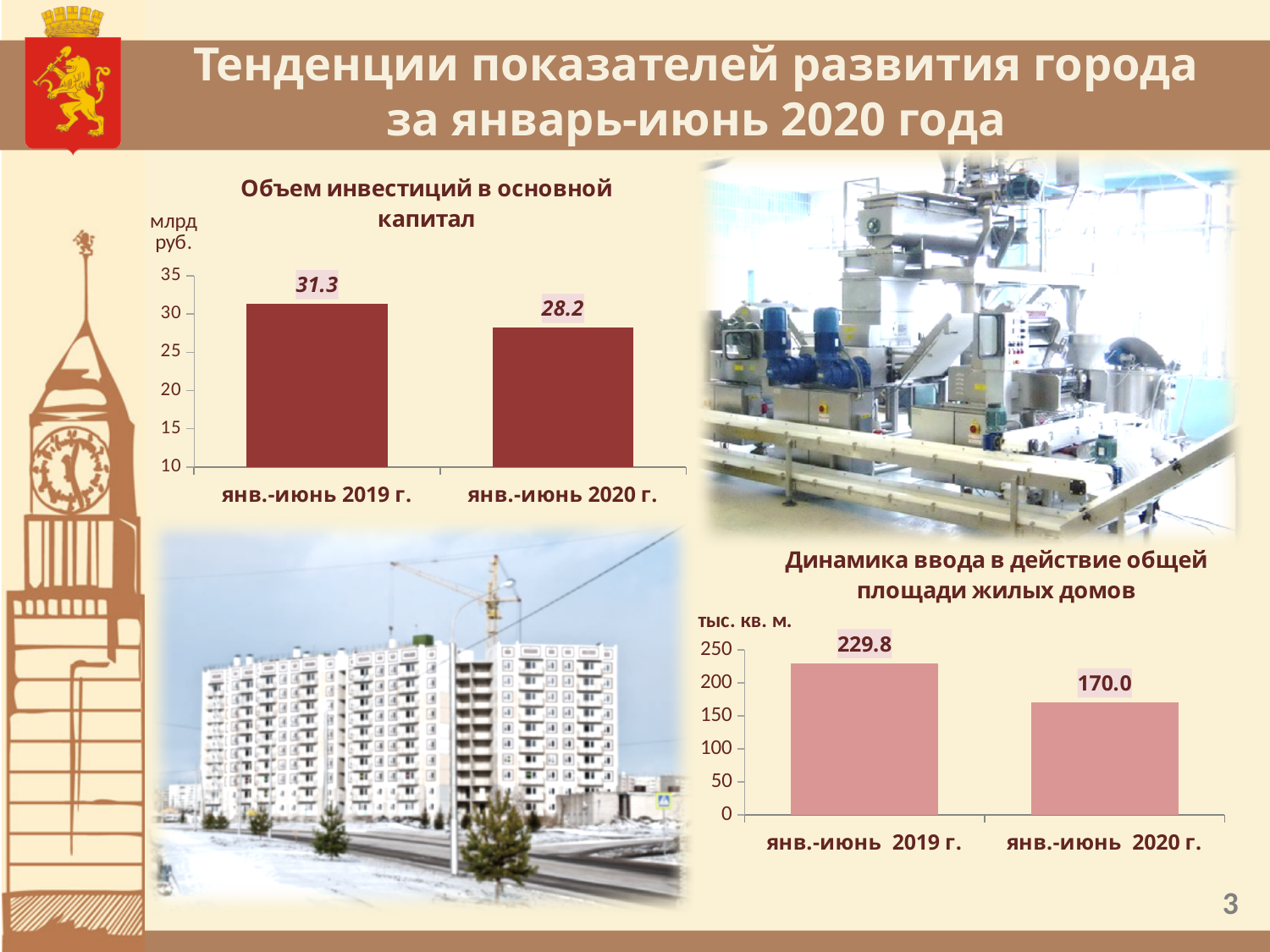
In the chart 'Объем инвестиций в основной капитал', do the values rise or fall from 2019 to 2020? fall In the chart 'Объем инвестиций в основной капитал', what is the value for янв.-июнь 2019 г.? 31.3 In the chart 'Динамика ввода в действие общей площади жилых домов', what is the value for янв.-июнь 2020 г.? 170.0 In the chart 'Объем инвестиций в основной капитал', what is the value for янв.-июнь 2020 г.? 28.2 In the chart 'Динамика ввода в действие общей площади жилых домов', what is the difference between the 2019 and 2020 values? 59.8 In the chart 'Динамика ввода в действие общей площади жилых домов', what is the value for янв.-июнь 2019 г.? 229.8 What type of chart is 'Динамика ввода в действие общей площади жилых домов'? bar chart In the chart 'Объем инвестиций в основной капитал', what is the difference between the 2019 and 2020 values? 3.1 In the chart 'Объем инвестиций в основной капитал', what unit is shown on the vertical axis? млрд руб. In the chart 'Динамика ввода в действие общей площади жилых домов', how many categories are plotted? 2 In the chart 'Объем инвестиций в основной капитал', which period has the higher value? янв.-июнь 2019 г. In the chart 'Динамика ввода в действие общей площади жилых домов', which period has the lower value? янв.-июнь 2020 г.